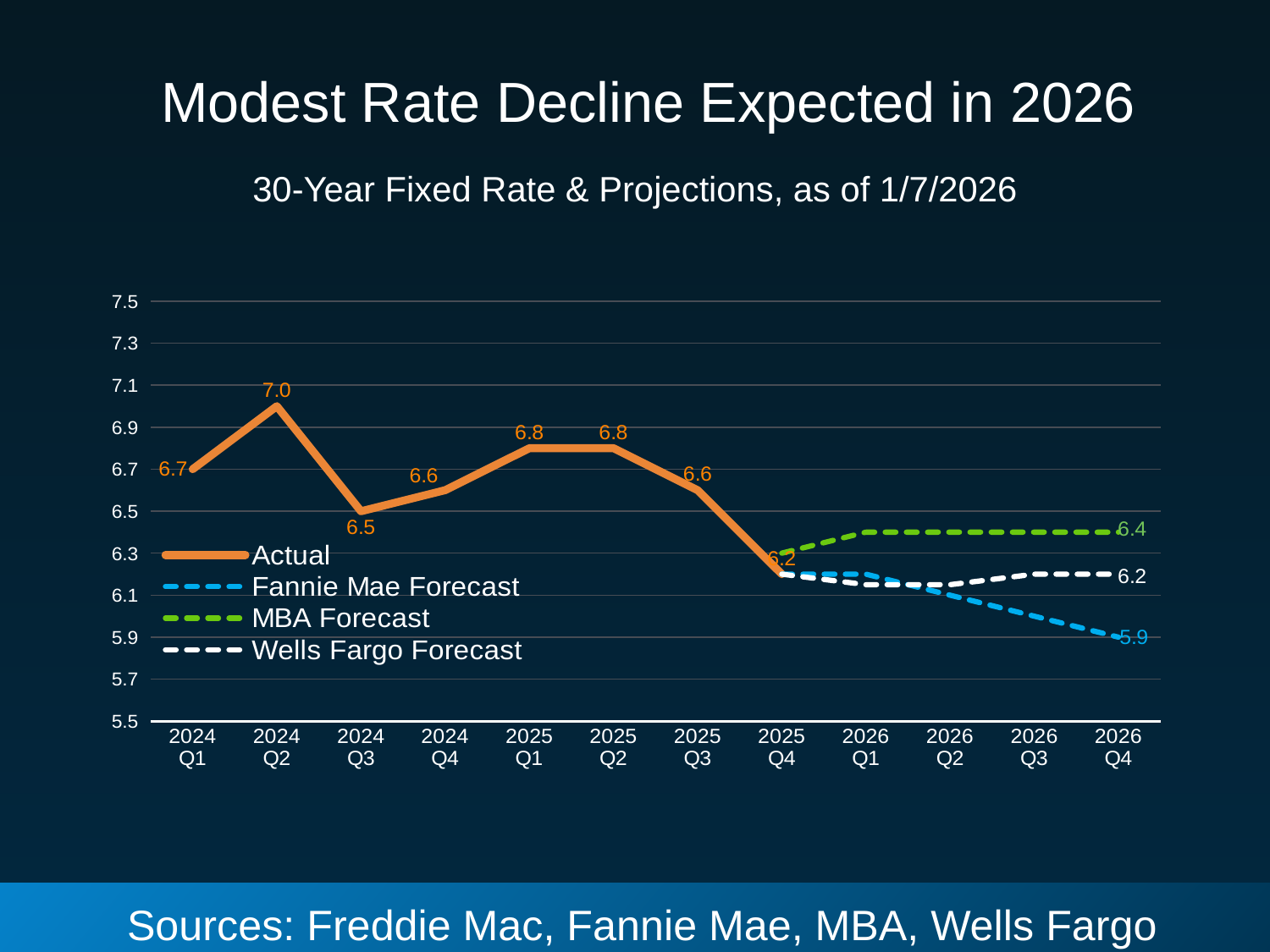
In which quarter does the Actual series reach its lowest value? 2025 Q4 What is the Fannie Mae Forecast value for 2026 Q4? 5.9 What type of chart is shown on the slide? Line chart In which quarter does the Actual series reach its highest value? 2024 Q2 What is the difference between the Actual rate in 2024 Q2 and the Actual rate in 2025 Q4? 0.8 Which forecast is higher for 2026 Q4, the MBA Forecast or the Fannie Mae Forecast? MBA Forecast What is the Wells Fargo Forecast value for 2026 Q4? 6.2 What is the Actual 30-year fixed rate for 2025 Q4? 6.2 What is the Actual 30-year fixed rate for 2024 Q2? 7.0 How many quarters are shown on the x axis? 12 How many series does the legend list? 4 What is the MBA Forecast value for 2026 Q4? 6.4